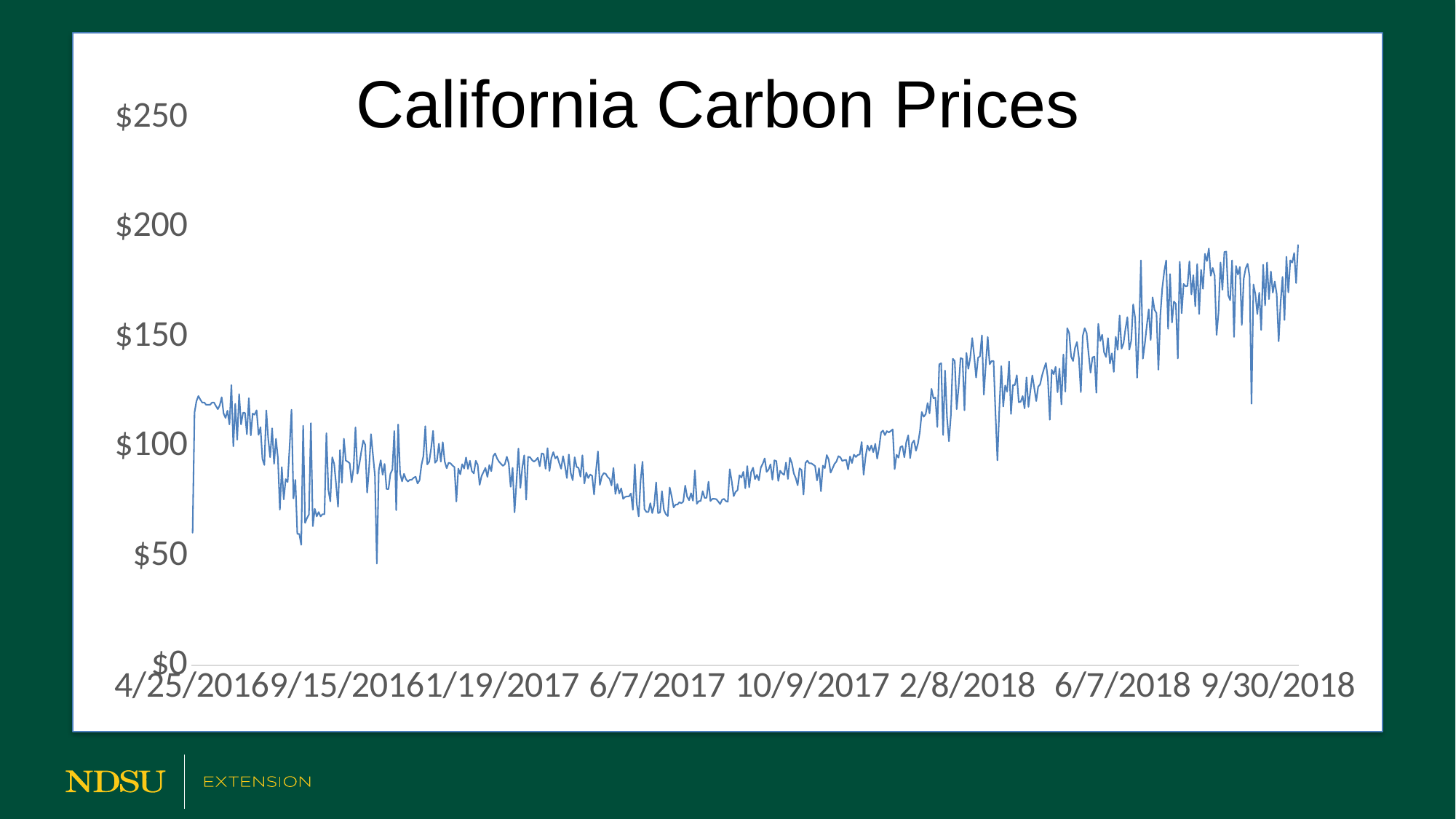
Is the value around 10/9/2017 greater or less than $100? less Is the value around 6/7/2018 greater or less than $100? greater In which part of the series does the line reach its highest values: near the beginning, the middle, or the end? the end Is the value around 2/8/2018 greater or less than $100? greater What is the title of the chart? California Carbon Prices Which is larger, the price at the start of the series (4/25/2016) or at the end (9/30/2018)? 9/30/2018 What is the highest value shown on the vertical axis? $250 Overall, do carbon prices rise or fall from the start of the series to the end? rise What kind of chart is shown on the slide? line chart